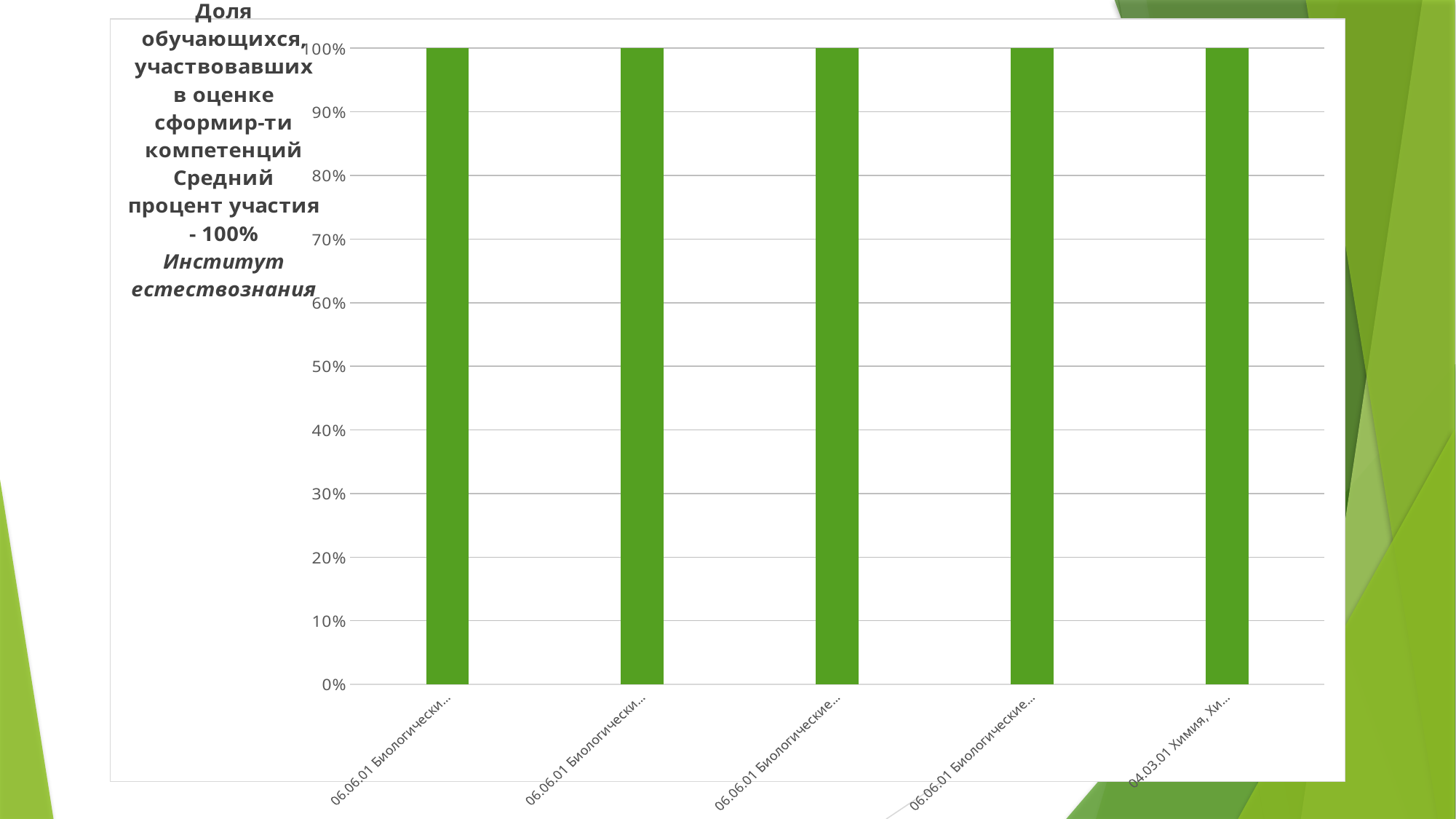
What is the value of the rightmost bar, labelled 04.03.01 Химия? 100% Do the bar values rise, fall, or stay the same from left to right across the chart? stay the same What is the value of the leftmost bar in the chart? 100% Is the value for the bar labelled 04.03.01 Химия greater or less than 50%? greater Which institute is named in the chart title? Институт естествознания Is the leftmost bar higher than, lower than, or equal to the rightmost bar? equal How many bars are plotted in the chart? 5 What kind of chart is shown on the slide? bar chart What colour are the bars in the chart? green What is the difference between the value of the leftmost bar and the value of the rightmost bar? 0%